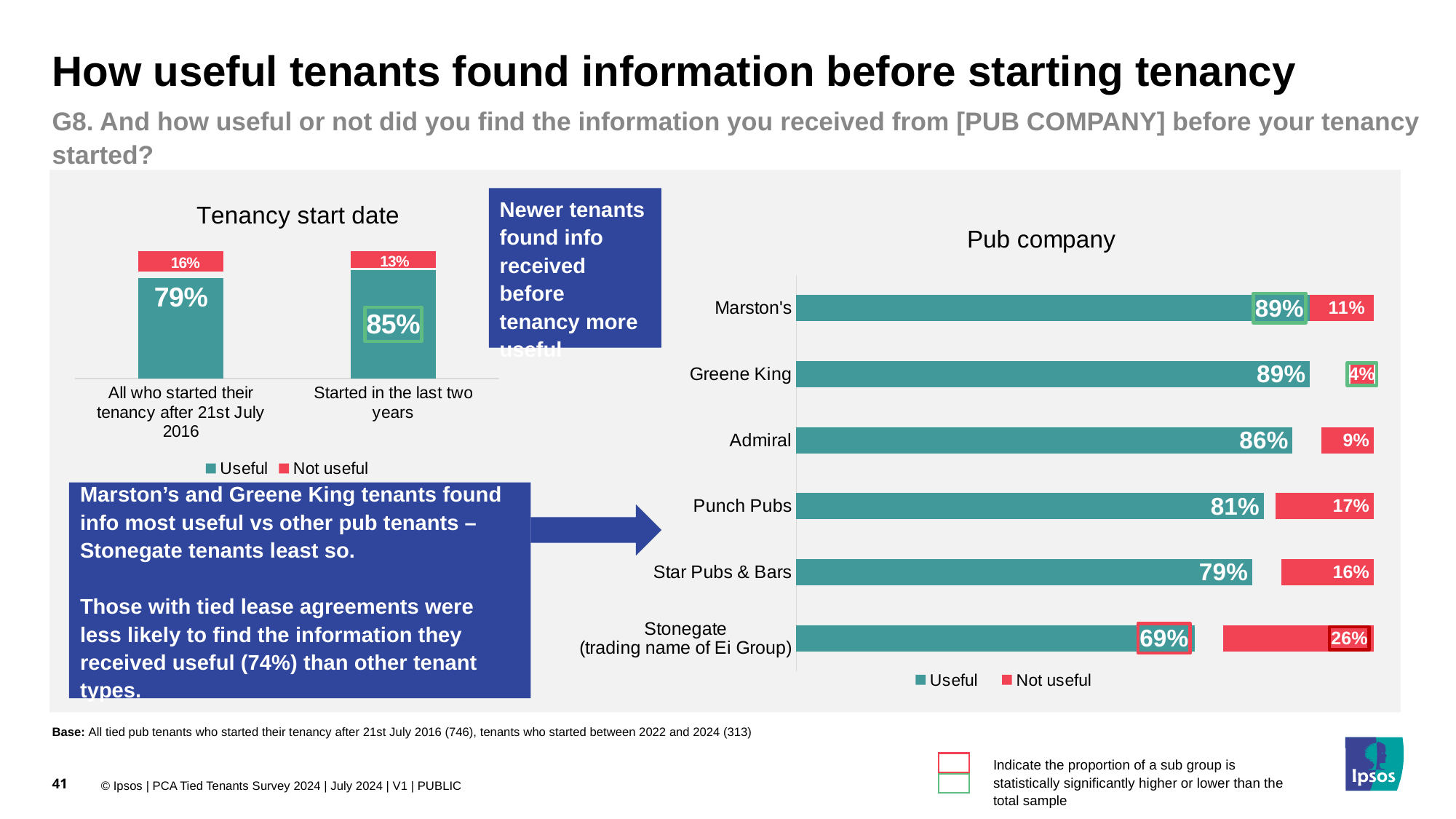
In the Pub company chart, which pub company has the highest Not useful percentage? Stonegate (trading name of Ei Group) How many series does the legend of the Pub company chart list? 2 In the Pub company chart, what percentage of Admiral tenants found the information useful? 86% In the Pub company chart, which has a higher Useful percentage, Punch Pubs or Star Pubs & Bars? Punch Pubs How many pub companies are shown in the Pub company chart? 6 In the Pub company chart, what is the difference between the Useful percentages for Marston's and Stonegate? 20 percentage points In the Pub company chart, which pub company has the lowest Not useful percentage? Greene King In the Tenancy start date chart, what is the difference in the Useful percentage between tenants who started in the last two years and all who started after 21st July 2016? 6 percentage points In the Pub company chart, which pub company has the lowest Useful percentage? Stonegate (trading name of Ei Group) In the Pub company chart, what is the Not useful value for Punch Pubs? 17% In the Tenancy start date chart, what percentage of tenants who started in the last two years found the information useful? 85% In the Tenancy start date chart, what is the Not useful value for all who started their tenancy after 21st July 2016? 16%